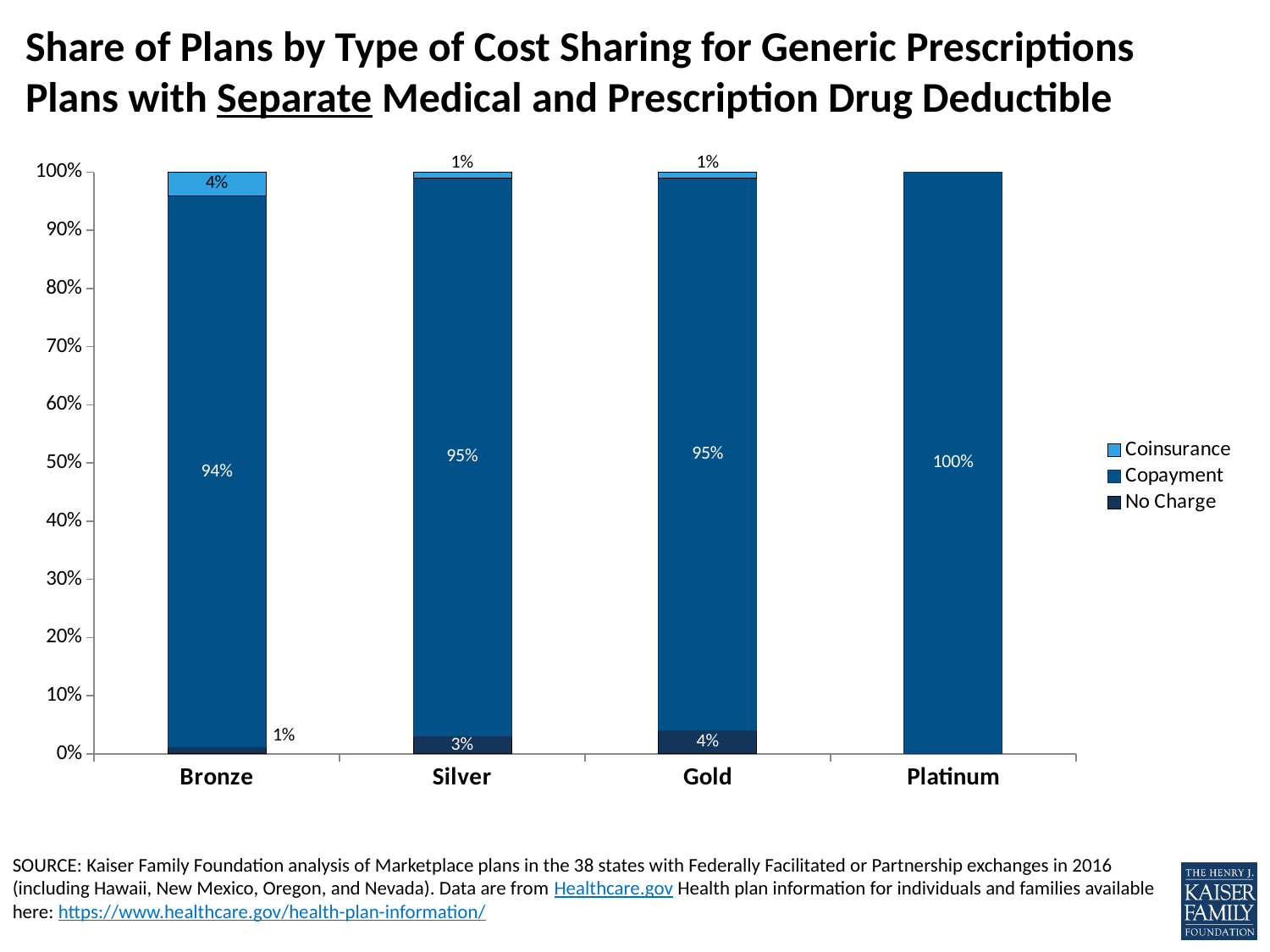
What is the No Charge share for Silver plans? 3% What kind of chart is shown on the slide? Stacked bar chart How many metal levels are shown on the x axis? 4 What is the Coinsurance share for Bronze plans? 4% Which metal level has the lowest Copayment share? Bronze What is the difference between the No Charge share for Gold and the No Charge share for Bronze? 3% What is the Copayment share for Bronze plans? 94% Which metal level has the highest Copayment share? Platinum What is the No Charge share for Gold plans? 4% Is the Coinsurance share larger for Bronze or for Silver? Bronze How many series does the legend list? 3 What is the Copayment share for Platinum plans? 100%